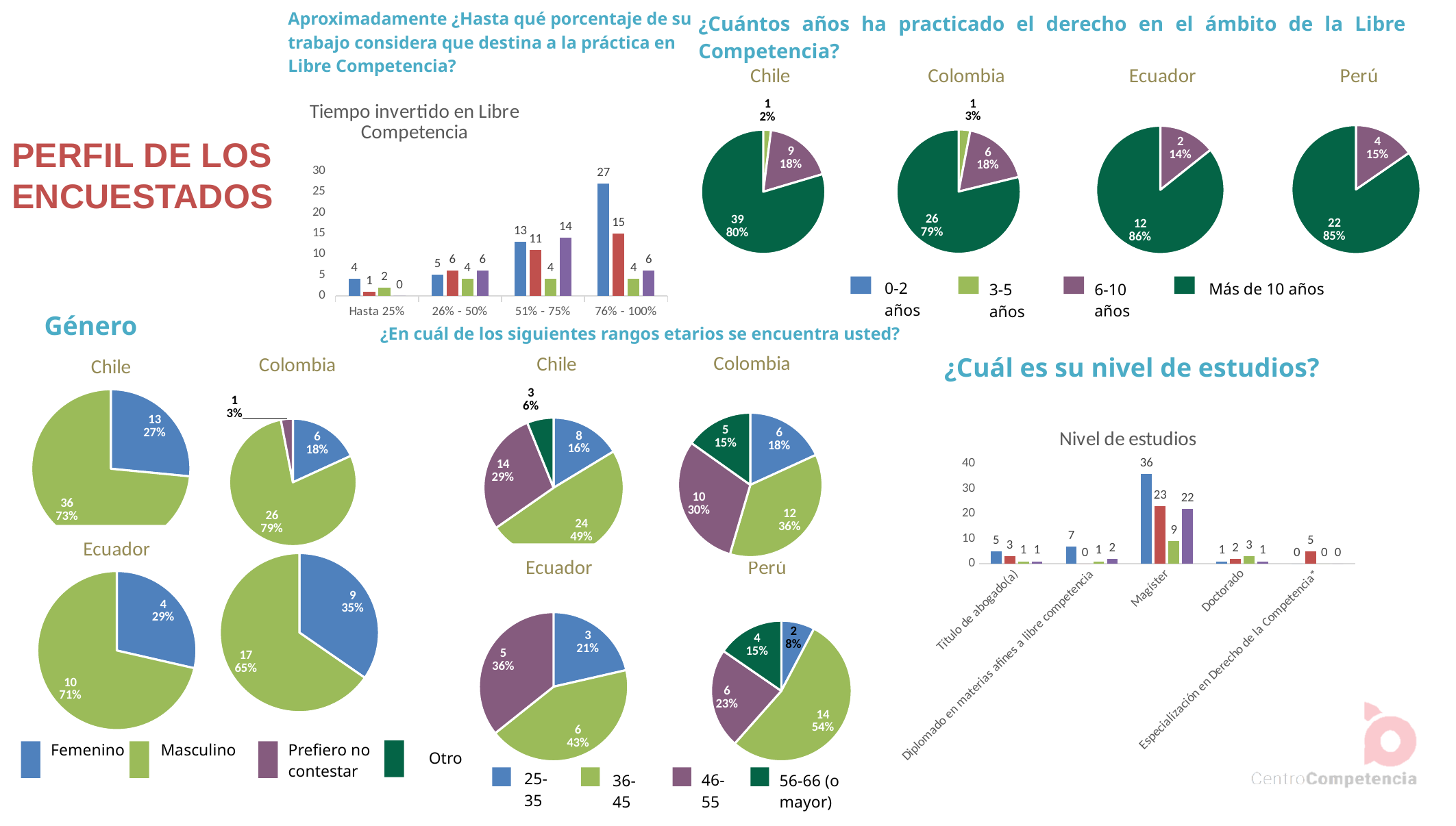
What type of chart is 'Nivel de estudios'? Bar chart In the Ecuador pie chart under '¿Cuántos años ha practicado el derecho en el ámbito de la Libre Competencia?', how many respondents are in the '6-10 años' slice? 2 In the Perú pie chart under '¿En cuál de los siguientes rangos etarios se encuentra usted?', what percentage corresponds to the '46-55' range? 23% In the 'Tiempo invertido en Libre Competencia' bar chart, what is the difference between the blue bar and the red bar in the '76% - 100%' category? 12 In the Chile pie chart under '¿Cuántos años ha practicado el derecho en el ámbito de la Libre Competencia?', what percentage corresponds to 'Más de 10 años'? 80% In the 'Nivel de estudios' bar chart, what is the value of the blue bar for 'Magíster'? 36 In the 'Tiempo invertido en Libre Competencia' bar chart, which category has the highest blue bar? 76% - 100% In the 'Tiempo invertido en Libre Competencia' bar chart, what is the value of the blue bar for the '76% - 100%' category? 27 In the 'Tiempo invertido en Libre Competencia' bar chart, how many categories are shown on the x axis? 4 In the Chile pie chart under '¿En cuál de los siguientes rangos etarios se encuentra usted?', which age range has the largest share? 36-45 In the Género pie chart for Chile, what percentage is Masculino? 73% In the Género pie chart for Colombia, how many respondents chose 'Prefiero no contestar'? 1